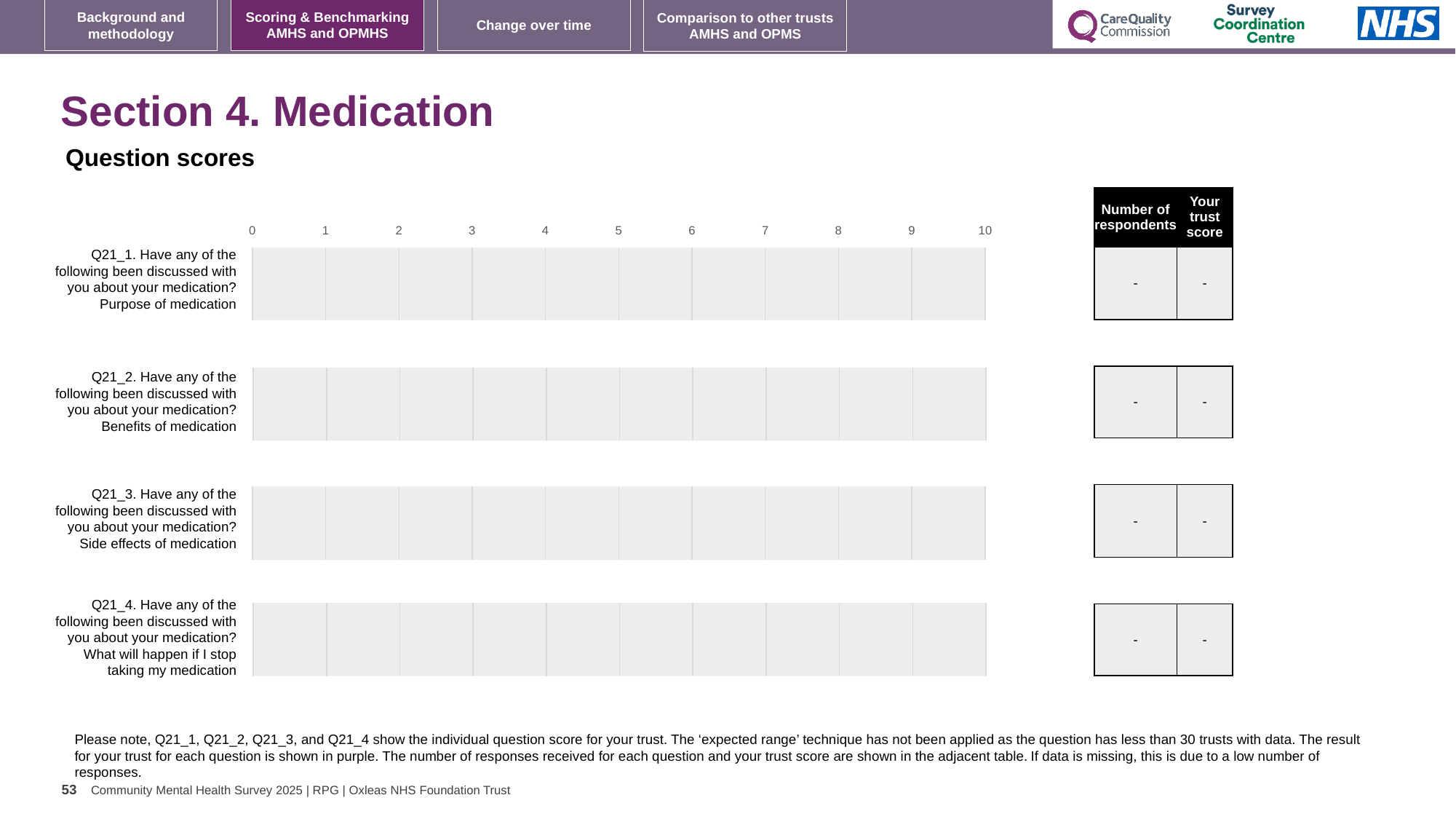
How many questions (categories) are listed on the question scores chart? 4 What is the trust score shown in the table for Q21_2 (Benefits of medication)? - What is the number of respondents shown in the table for Q21_1 (Purpose of medication)? - What is the number of respondents shown in the table for Q21_4 (What will happen if I stop taking my medication)? - What is the trust score shown in the table for Q21_3 (Side effects of medication)? - What is the lowest value shown on the x axis of the question scores chart? 0 What kind of chart is used to show the question scores on this slide? bar chart What is the highest value shown on the x axis of the question scores chart? 10